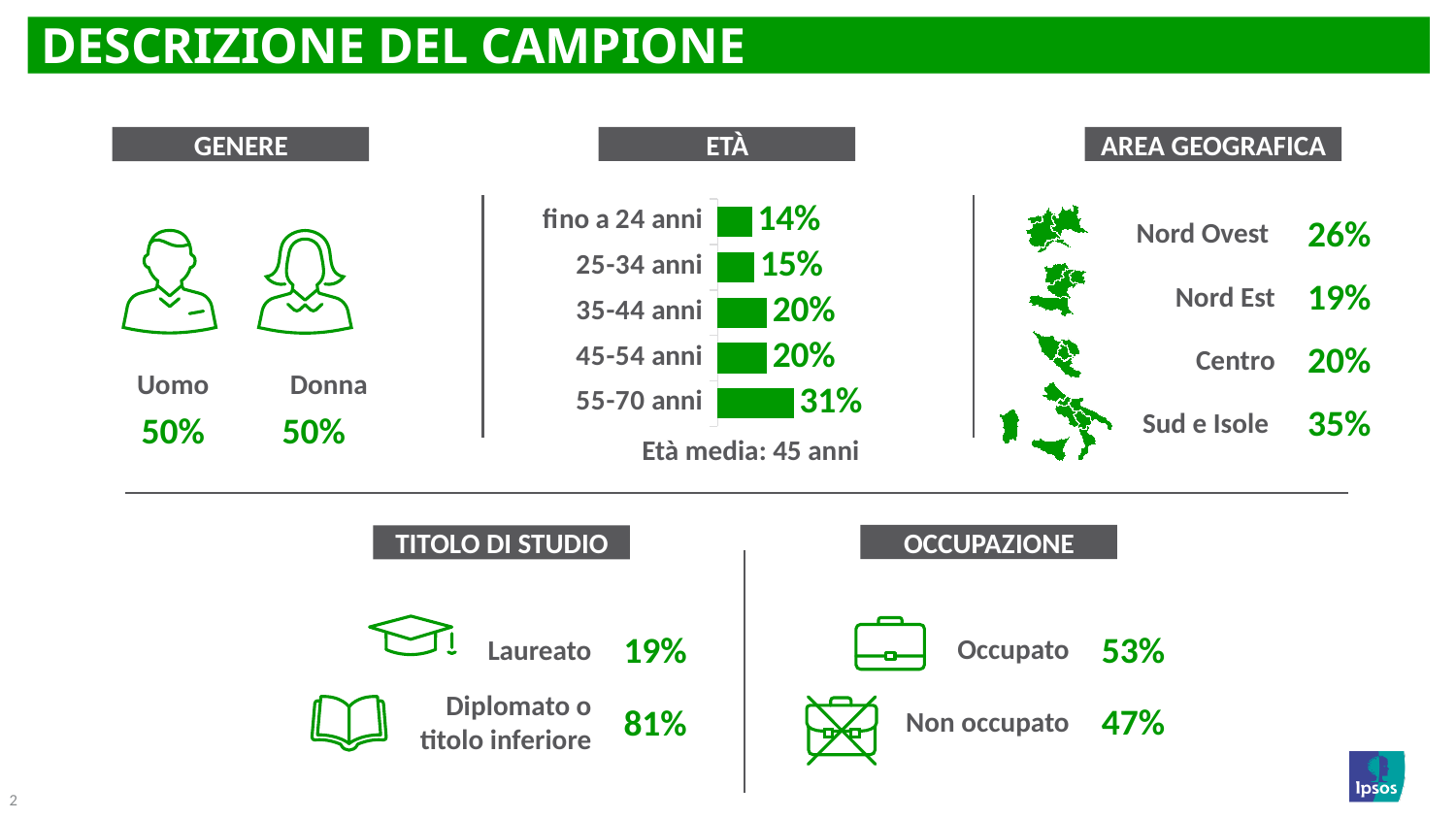
In the ETÀ chart, what is the difference between the values for 55-70 anni and 45-54 anni? 11% In the ETÀ chart, which age group has the highest value? 55-70 anni In the ETÀ chart, which is larger: the value for 35-44 anni or the value for 25-34 anni? 35-44 anni How many age groups are shown in the ETÀ chart? 5 In the ETÀ chart, what is the value for 55-70 anni? 31% What kind of chart is the ETÀ chart? Bar chart In the ETÀ chart, what is the value for fino a 24 anni? 14% In the ETÀ chart, do the values rise or fall going from fino a 24 anni down to 55-70 anni? Rise In the ETÀ chart, which age group has the lowest value? fino a 24 anni In the ETÀ chart, what is the difference between the values for 25-34 anni and fino a 24 anni? 1% What average age (Età media) is stated below the ETÀ chart? 45 anni In the ETÀ chart, what is the value for 25-34 anni? 15%